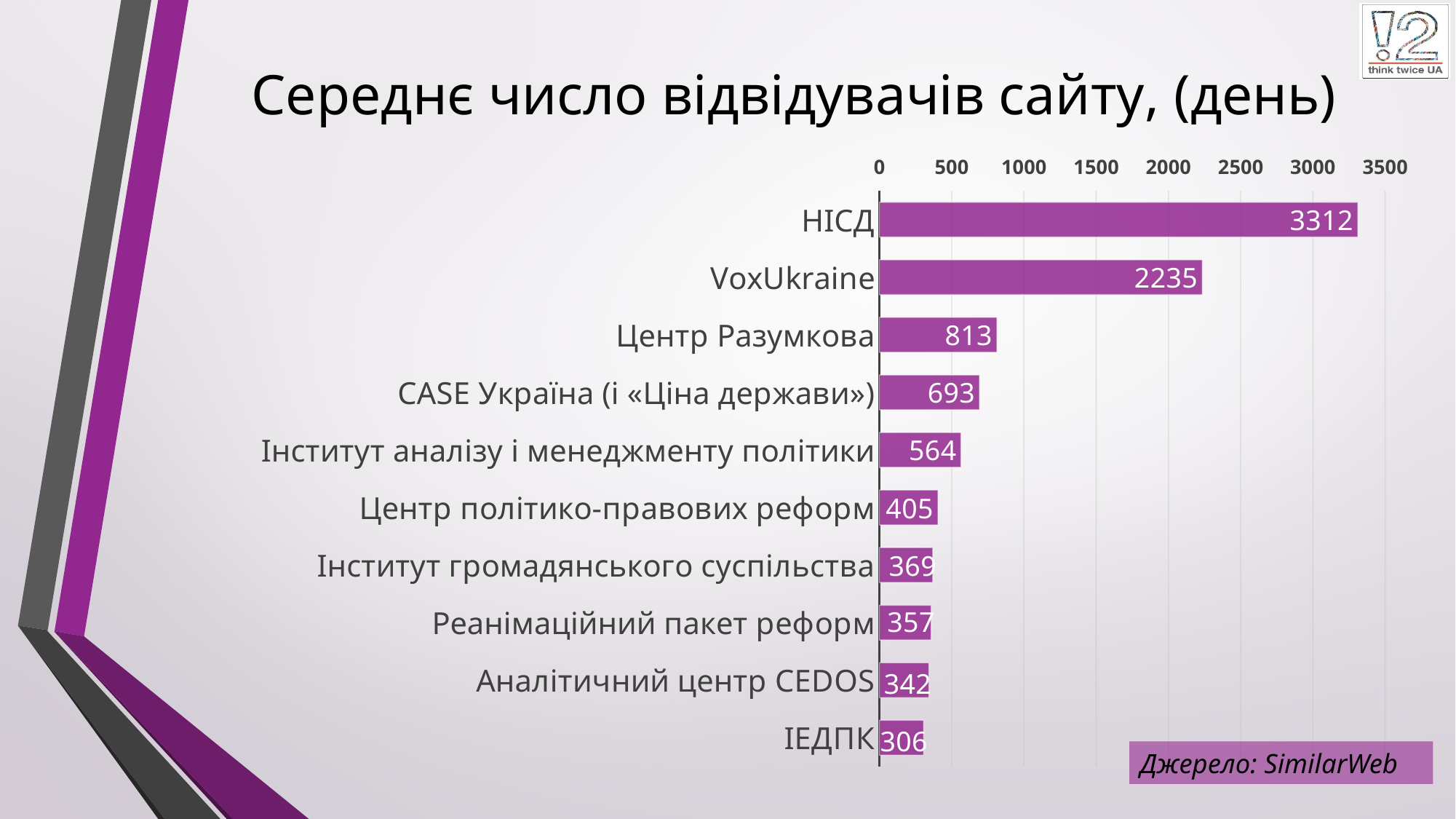
What is the value shown for Реанімаційний пакет реформ? 357 What is the difference between the values for НІСД and VoxUkraine? 1077 What is the title of the chart? Середнє число відвідувачів сайту, (день) Which organisation has the lowest average daily number of site visitors? ІЕДПК What is the value shown for VoxUkraine? 2235 What is the value shown for Центр Разумкова? 813 What is the difference between the values for Центр Разумкова and CASE Україна (і «Ціна держави»)? 120 Which organisation has the highest average daily number of site visitors? НІСД Which has a larger value: Інститут аналізу і менеджменту політики or Центр політико-правових реформ? Інститут аналізу і менеджменту політики What is the average daily number of site visitors for НІСД? 3312 What kind of chart is shown on the slide? Bar chart How many organisations are shown in the chart? 10